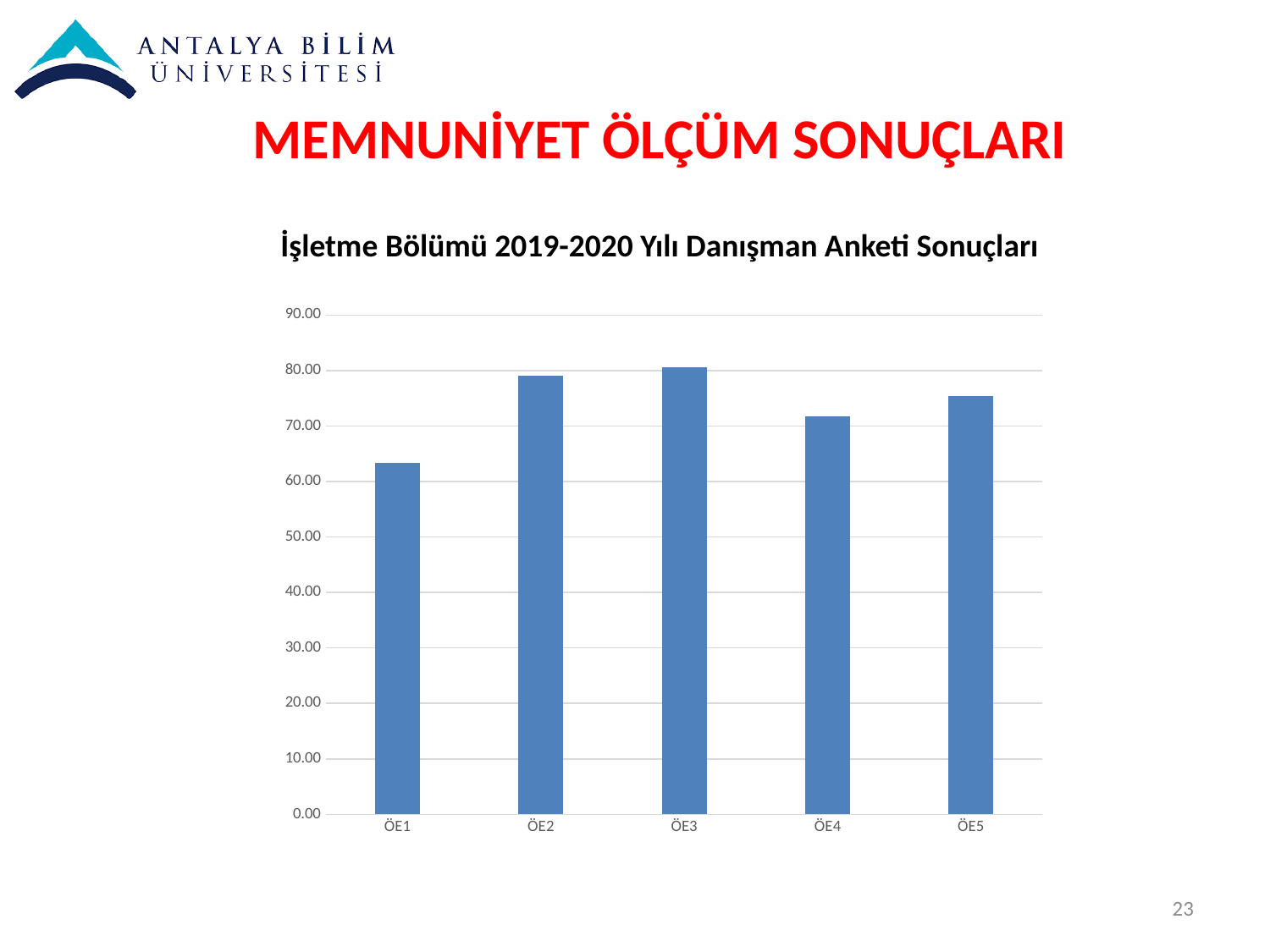
What is the title of the chart? İşletme Bölümü 2019-2020 Yılı Danışman Anketi Sonuçları Which is larger, the value for ÖE2 or the value for ÖE4? ÖE2 What type of chart is shown on the slide? bar chart Which category has the lowest value in the chart? ÖE1 Does the value rise or fall from ÖE1 to ÖE2? rise Is the value for ÖE4 greater or less than 70? greater How many categories are shown on the x axis of the chart? 5 Is the value for ÖE5 greater or less than 80? less Which is larger, the value for ÖE5 or the value for ÖE1? ÖE5 Is the value for ÖE1 greater or less than 70? less Which category has the highest value in the chart? ÖE3